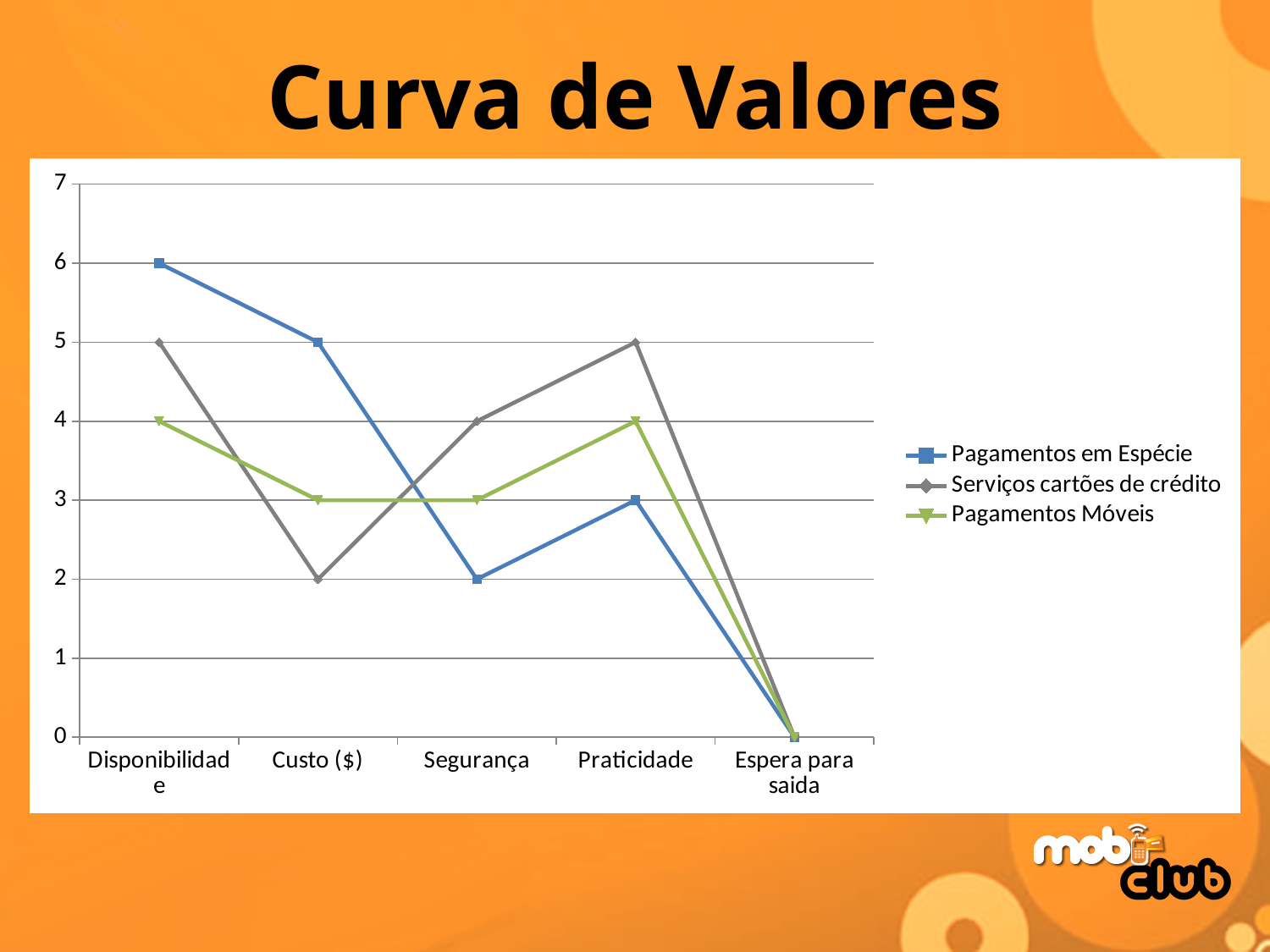
Which series has the highest value at Segurança? Serviços cartões de crédito What is the value for Pagamentos em Espécie at Disponibilidade? 6 What is the difference between Pagamentos em Espécie and Pagamentos Móveis at Disponibilidade? 2 How many categories are shown on the x axis? 5 What kind of chart is shown on the slide? line chart What is the value for Pagamentos Móveis at Praticidade? 4 What is the title of the chart on the slide? Curva de Valores What value do all three series have at Espera para saida? 0 Which series has the lowest value at Custo ($)? Serviços cartões de crédito How many series does the legend list? 3 What is the value for Serviços cartões de crédito at Custo ($)? 2 Which is larger at Praticidade: Pagamentos em Espécie or Serviços cartões de crédito? Serviços cartões de crédito